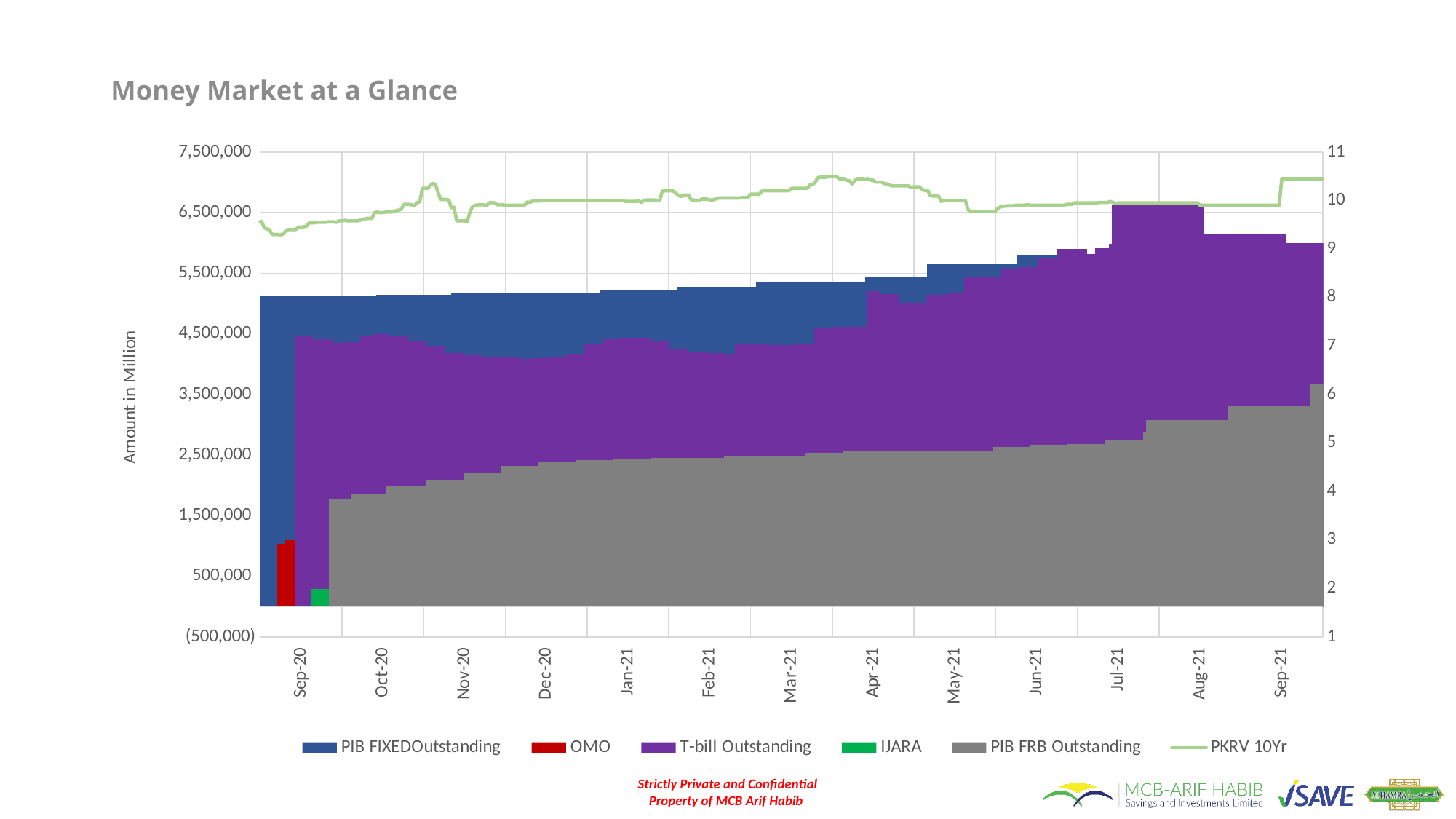
Is the PIB FRB Outstanding value at Oct-20 greater or less than 2,500,000? less At Sep-21, which is larger: the PIB FRB Outstanding portion or the T-bill Outstanding portion? T-bill Outstanding At Oct-20, which is larger: the T-bill Outstanding portion or the PIB FIXED Outstanding portion? PIB FIXEDOutstanding How many series does the chart legend list? 6 What is the label of the left vertical axis? Amount in Million Is the PKRV 10Yr value at Sep-21 greater or less than 10 on the right axis? greater Does the PIB FRB Outstanding series rise or fall from Sep-20 to Sep-21? rise What is the title of the chart? Money Market at a Glance Is the total stacked amount at Sep-21 greater or less than 5,500,000? greater How many month labels are shown along the x axis? 13 Which series is drawn as a line rather than as a filled area? PKRV 10Yr